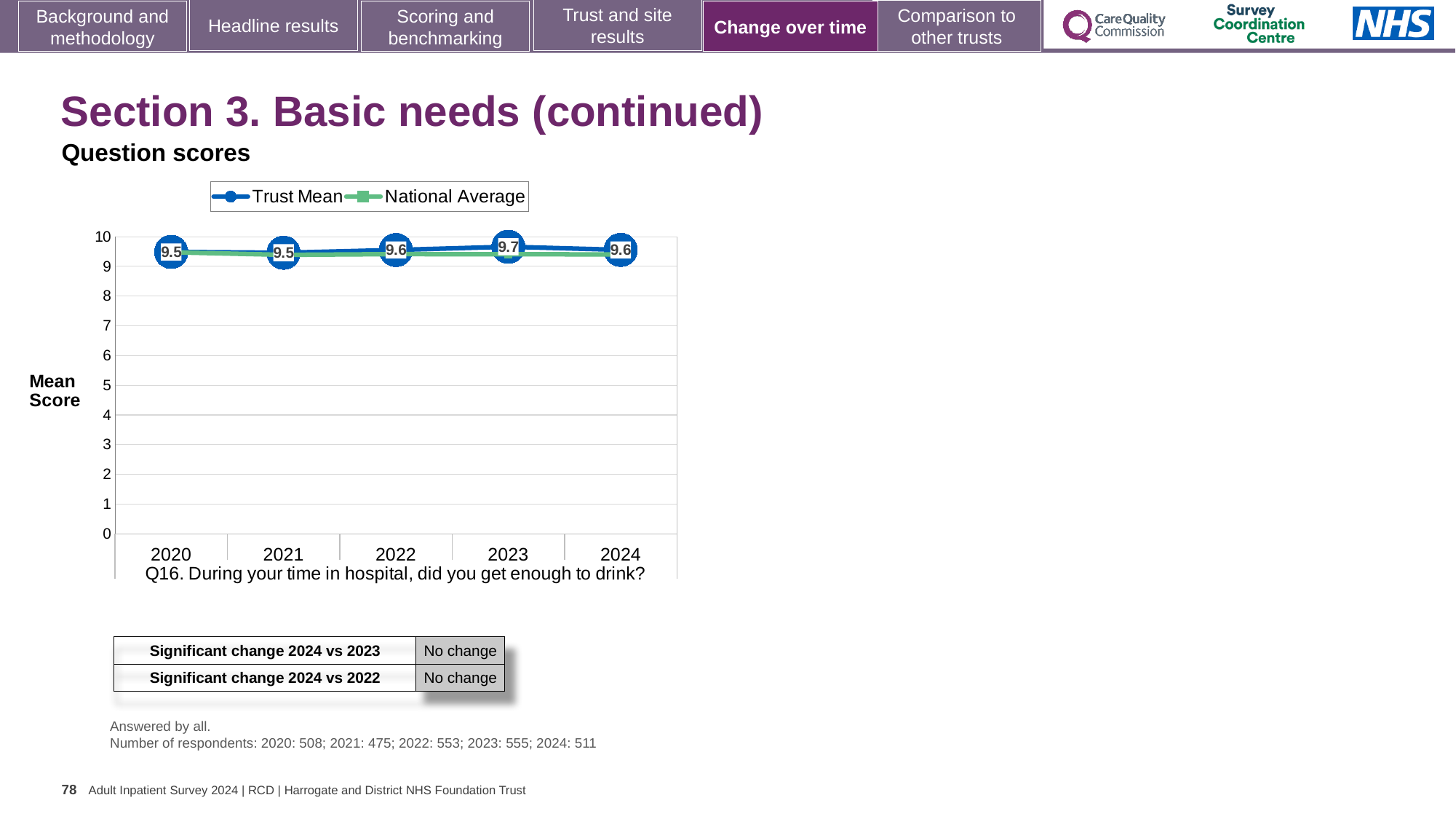
What is the difference between the Trust Mean score in 2023 and in 2020? 0.2 How many series does the legend list? 2 Is the National Average value for 2024 greater or less than 9? greater In which year is the Trust Mean score highest? 2023 What is the Trust Mean score for 2024? 9.6 Which question does the chart show scores for? Q16. During your time in hospital, did you get enough to drink? What is the Trust Mean score for 2023? 9.7 What is the Trust Mean score for 2020? 9.5 Which is larger, the Trust Mean score for 2023 or for 2021? 2023 Does the Trust Mean score rise or fall from 2020 to 2023? Rise What kind of chart is shown on the slide? Line chart How many years are plotted on the x axis? 5